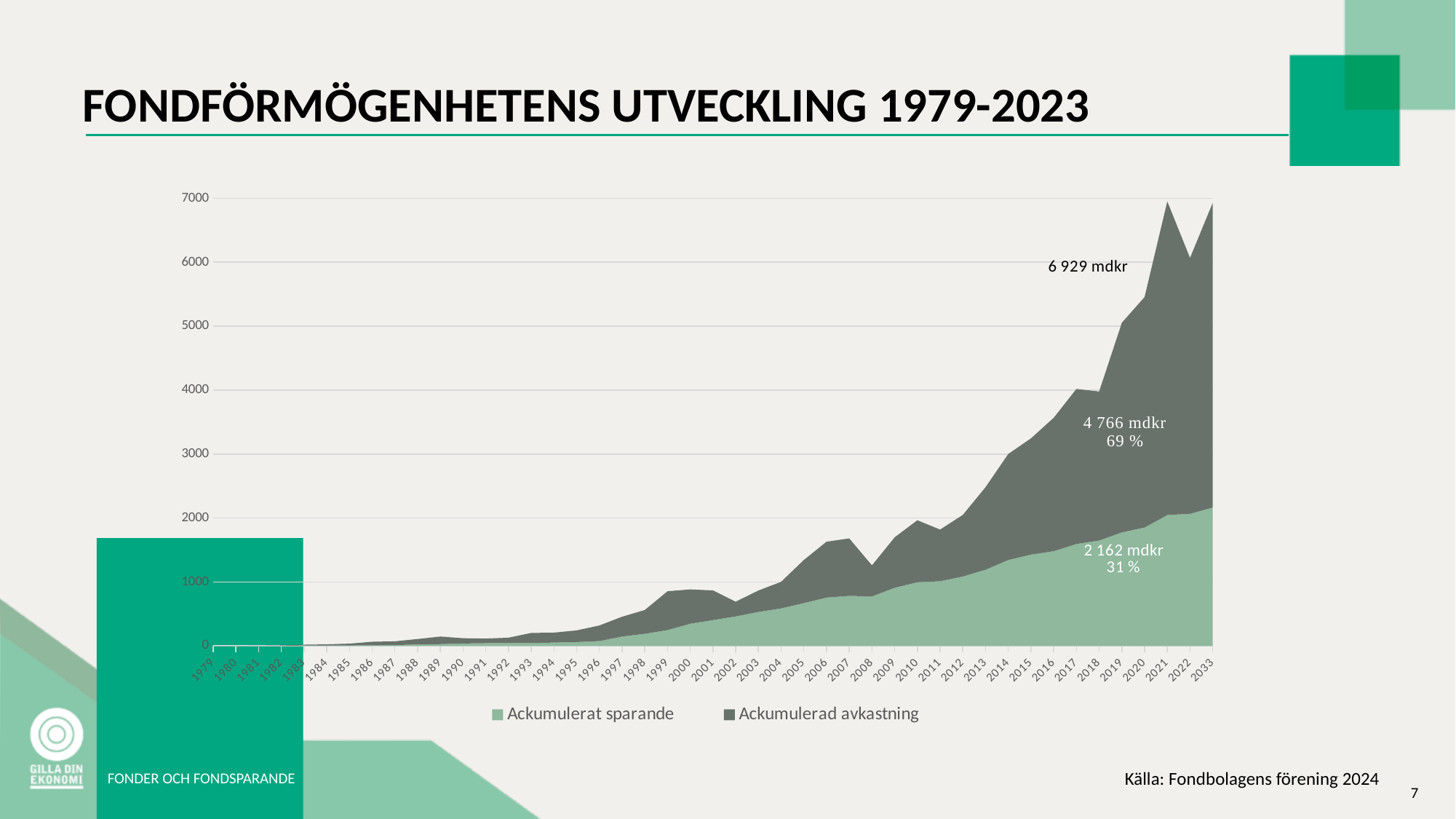
What is the title of the chart on the slide? FONDFÖRMÖGENHETENS UTVECKLING 1979-2023 How many series does the legend list? 2 What share of the total does Ackumulerat sparande account for, according to the label? 31 % Which series has the larger labelled value at the end of the period, Ackumulerat sparande or Ackumulerad avkastning? Ackumulerad avkastning What is the labelled value for Ackumulerat sparande at the end of the period? 2 162 mdkr What kind of chart is shown on the slide? Area chart What is the labelled value for Ackumulerad avkastning at the end of the period? 4 766 mdkr What is the difference between the labelled values for Ackumulerad avkastning (4 766 mdkr) and Ackumulerat sparande (2 162 mdkr)? 2 604 mdkr What share of the total does Ackumulerad avkastning account for, according to the label? 69 % What is the labelled total fund wealth at the end of the period? 6 929 mdkr Does the total fund wealth generally rise or fall from 1979 to the end of the period? Rise Is the total value in 2021 greater or less than 6000? greater